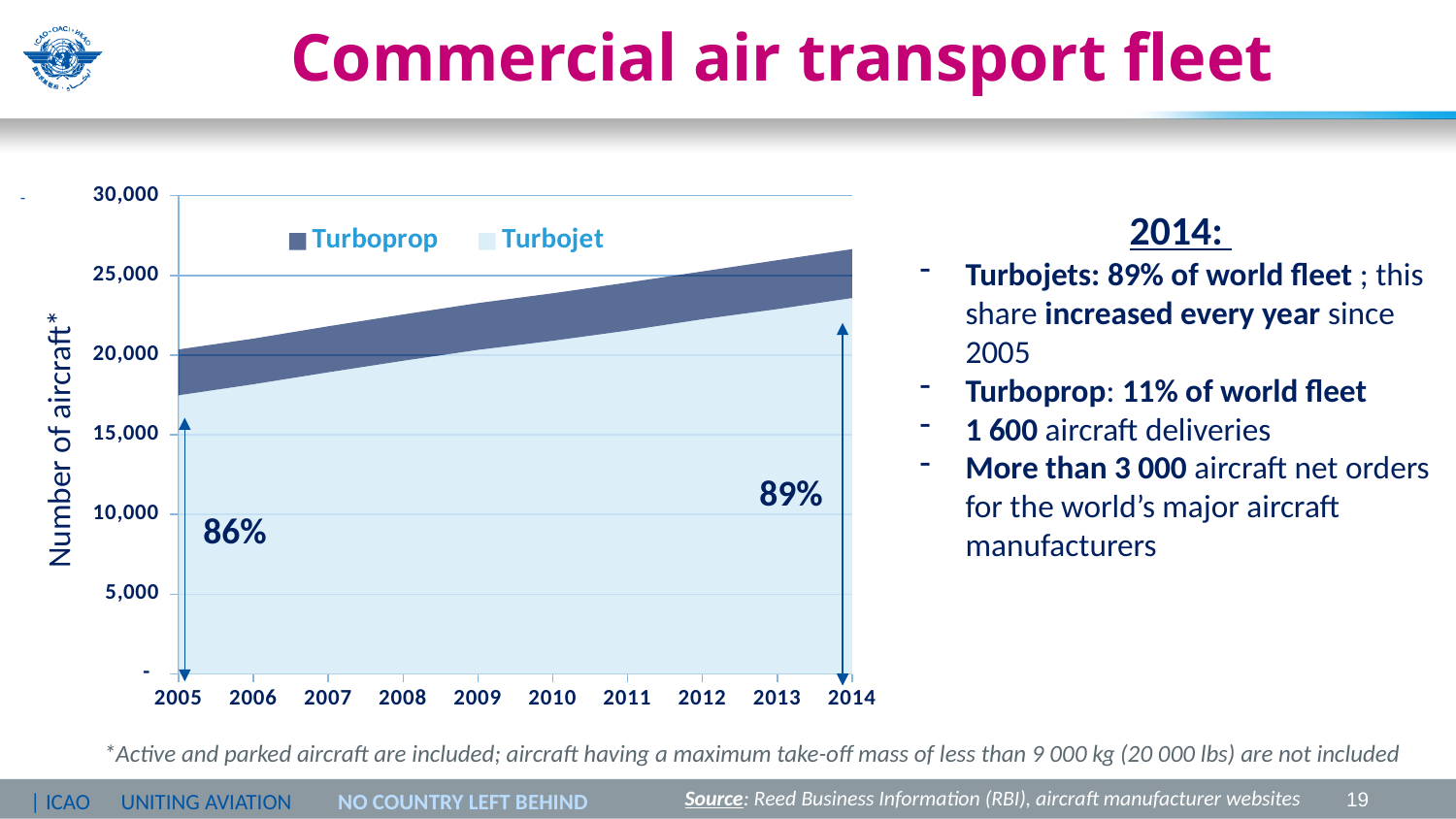
Which two series are listed in the chart legend? Turboprop and Turbojet What percentage label is shown on the chart for 2005? 86% What kind of chart is shown on the slide? Stacked area chart What percentage label is shown on the chart for 2014? 89% Does the total number of aircraft rise or fall from 2005 to 2014? Rise How many series does the chart legend list? 2 Which series is larger in 2014, Turboprop or Turbojet? Turbojet How many years are shown along the x axis of the chart? 10 Is the total number of aircraft in 2014 greater or less than 25,000? greater Is the Turbojet value for 2005 greater or less than 20,000? less What is the first year shown on the x axis of the chart? 2005 What is the last year shown on the x axis of the chart? 2014